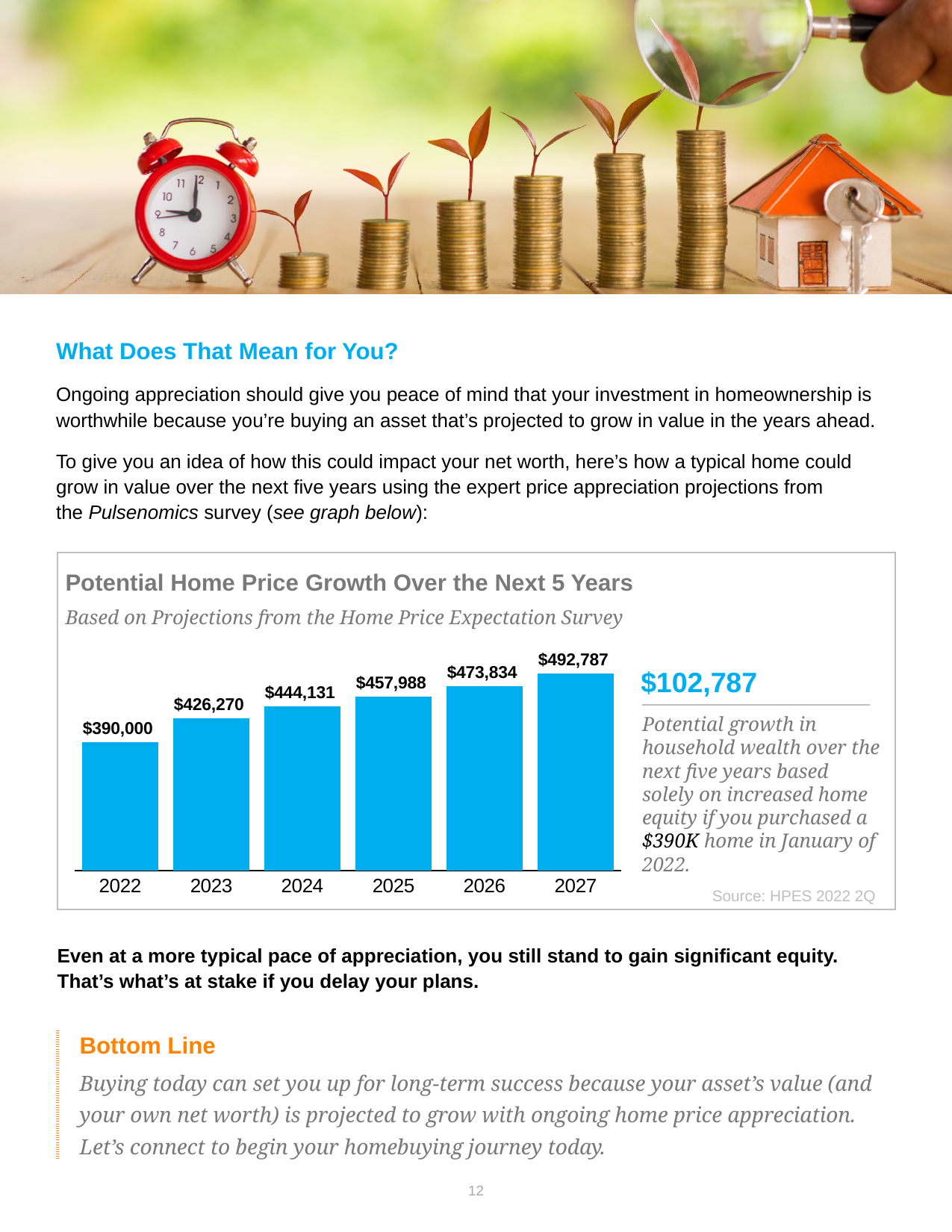
What is the projected home price for 2027? $492,787 Which year has the highest projected home price? 2027 What kind of chart is shown? Bar chart What is the difference between the 2027 and 2022 home prices? $102,787 What is the home price shown for 2022? $390,000 Do the home prices rise or fall from 2022 to 2027? Rise What is the difference between the 2023 and 2022 home prices? $36,270 How many years are shown on the chart? 6 Which is larger, the home price for 2025 or for 2026? 2026 What is the projected home price for 2024? $444,131 What is the title of the chart? Potential Home Price Growth Over the Next 5 Years Which year has the lowest home price on the chart? 2022